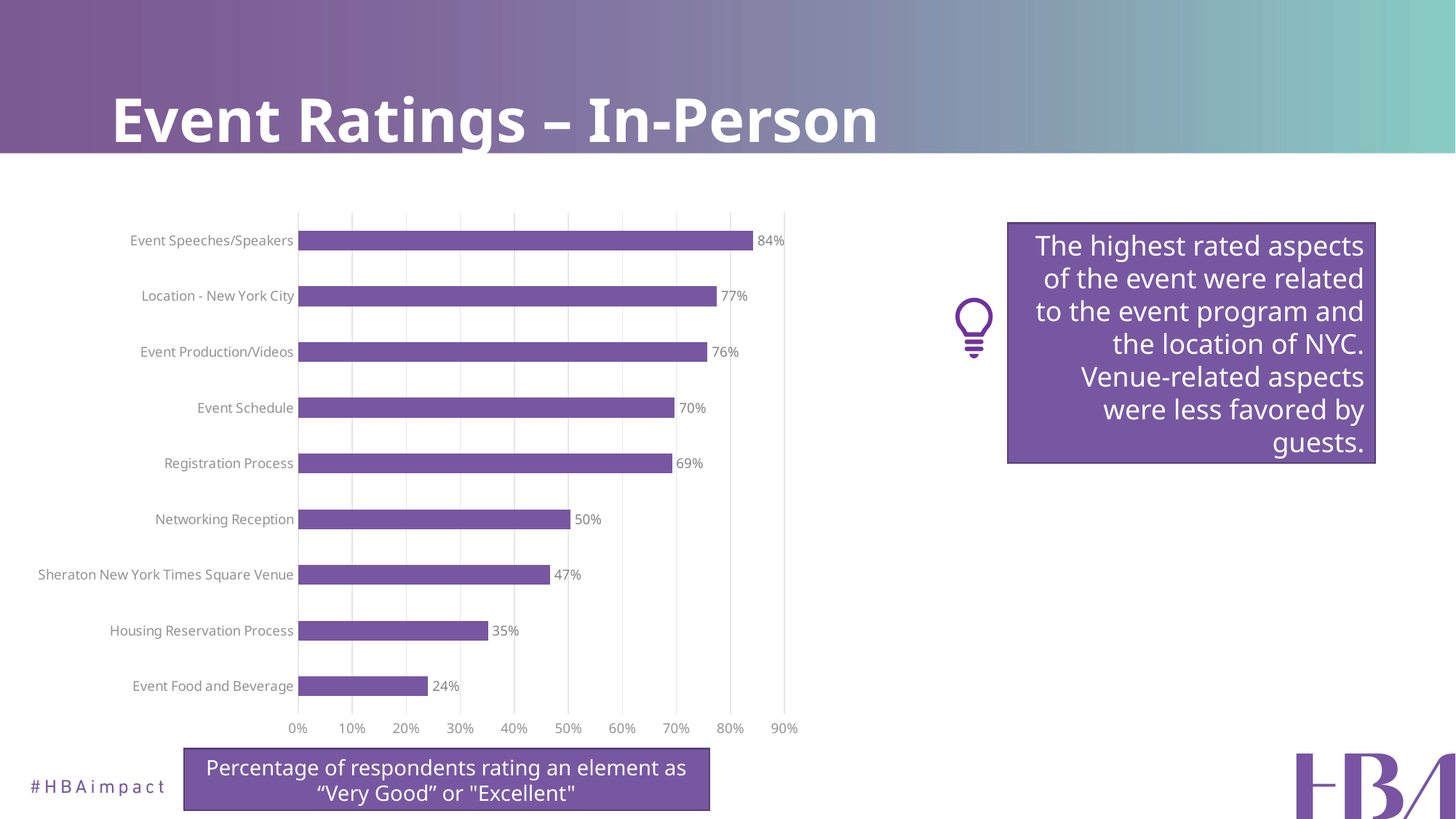
Which element has the highest rating in the chart? Event Speeches/Speakers What is the value shown for Housing Reservation Process? 35% What is the difference between the ratings for Location - New York City and Sheraton New York Times Square Venue? 30% What is the title of the slide containing the chart? Event Ratings – In-Person What is the value shown for Networking Reception? 50% What is the difference between the ratings for Event Schedule and Registration Process? 1% How many elements are rated in the chart? 9 What percentage of respondents rated Event Speeches/Speakers as "Very Good" or "Excellent"? 84% Is the value for Housing Reservation Process greater or less than 40%? less What kind of chart is shown on the slide? Bar chart Which is rated higher, Event Production/Videos or Networking Reception? Event Production/Videos Which element has the lowest rating in the chart? Event Food and Beverage